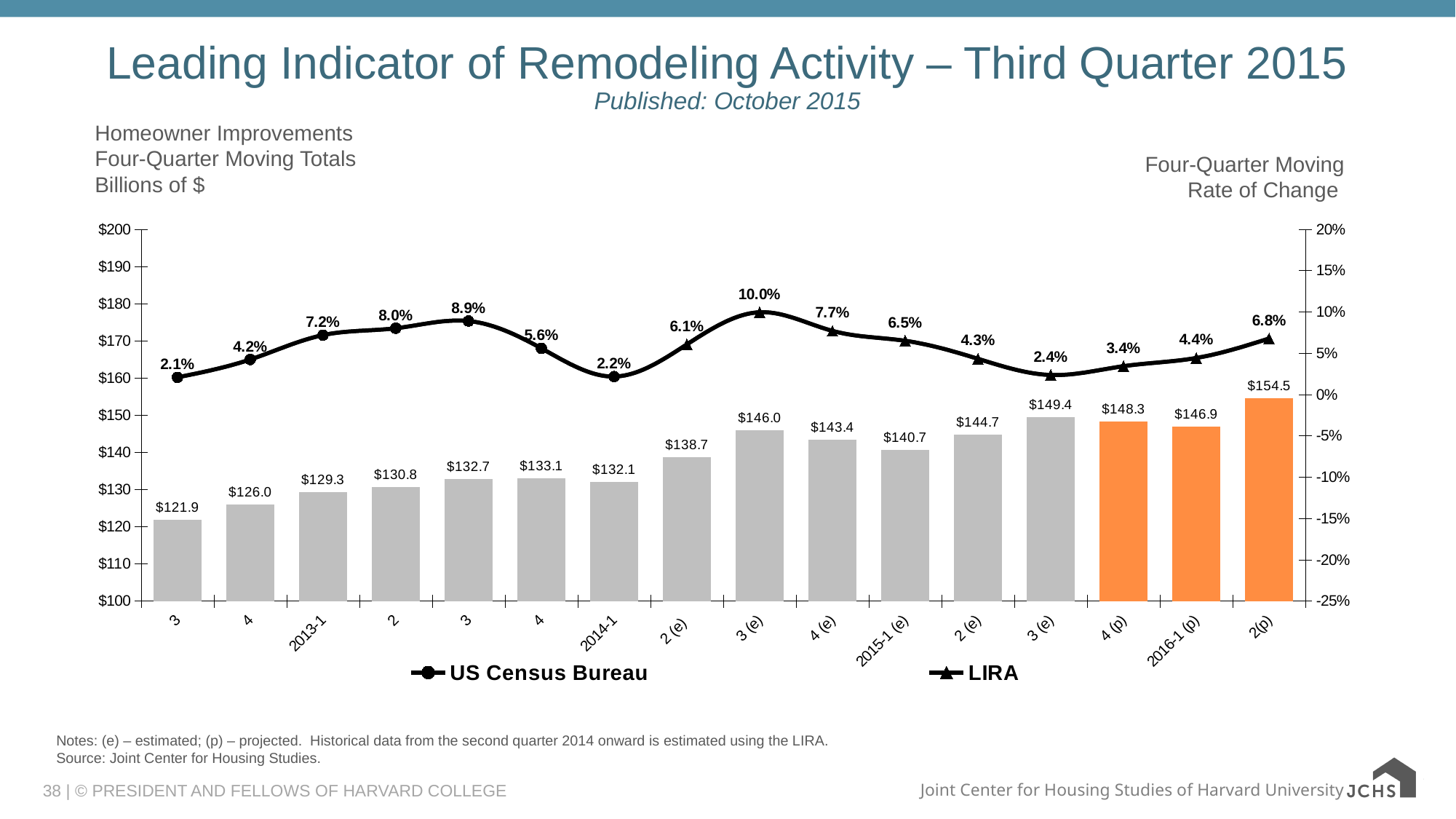
What is the four-quarter moving total for 2013-1? $129.3 What colour are the bars for the projected (p) periods? Orange What kind of chart is shown on the slide? Combination bar and line chart How many bars are plotted in the chart? 16 Which period has the highest four-quarter moving total? 2(p) What is the lowest four-quarter moving rate of change shown on the line? 2.1% What is the difference between the four-quarter moving totals for 2(p) and 3 (e) in 2015? $5.1 Which has the larger four-quarter moving total, 2015-1 (e) or 2014-1? 2015-1 (e) Does the rate of change line rise or fall from 3 (e) in 2014 to 3 (e) in 2015? Fall What is the four-quarter moving total for 2016-1 (p)? $146.9 How many series does the legend list? 2